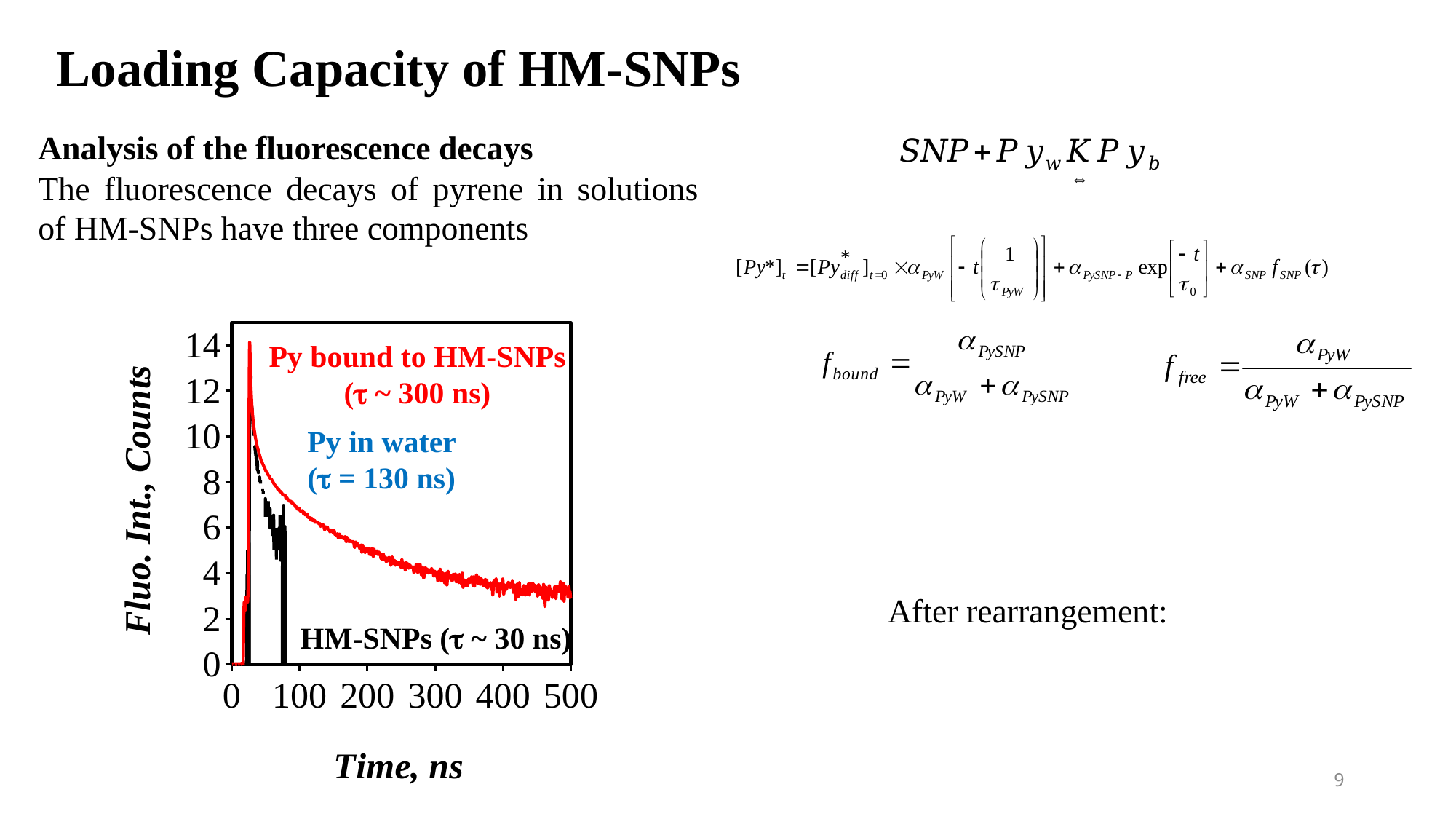
Does the red fluorescence decay curve rise or fall as time increases after its peak? fall What lifetime is given for the Py in water component? τ = 130 ns Is the value of the red curve at 100 ns greater or less than 6? greater How many decay components are labelled on the chart? 3 What is the maximum value shown on the x axis of the chart? 500 What lifetime is given for the Py bound to HM-SNPs component? τ ~ 300 ns What is the label of the y axis of the chart? Fluo. Int., Counts What lifetime is given for the HM-SNPs component? τ ~ 30 ns What is the label of the x axis of the chart? Time, ns Is the value of the red curve at 500 ns greater or less than 4? less Is the peak value of the red curve greater or less than 12? greater What kind of chart is shown on the slide? line chart